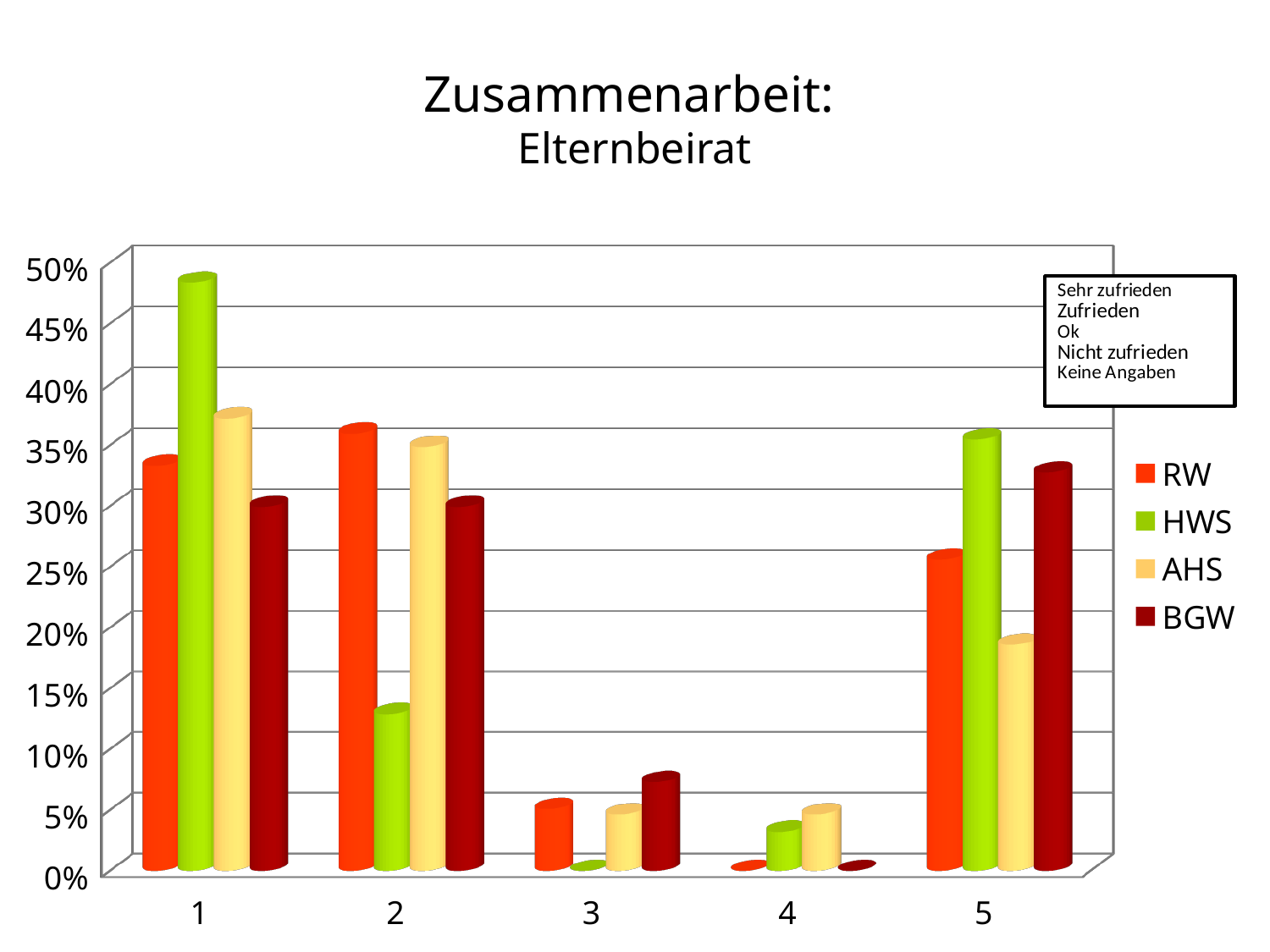
Which series has the highest value in category 1? HWS What kind of chart is shown on the slide? bar chart What is the title of the chart? Zusammenarbeit: Elternbeirat Which series has the lowest value in category 2? HWS Is the value for AHS in category 5 greater or less than 20%? less Is the value for RW in category 5 greater or less than 20%? greater Is the value for HWS in category 1 greater or less than 45%? greater In category 2, which is larger, the value for RW or the value for HWS? RW Which series has the lowest value in category 5? AHS How many categories are shown on the x axis? 5 How many series does the legend list? 4